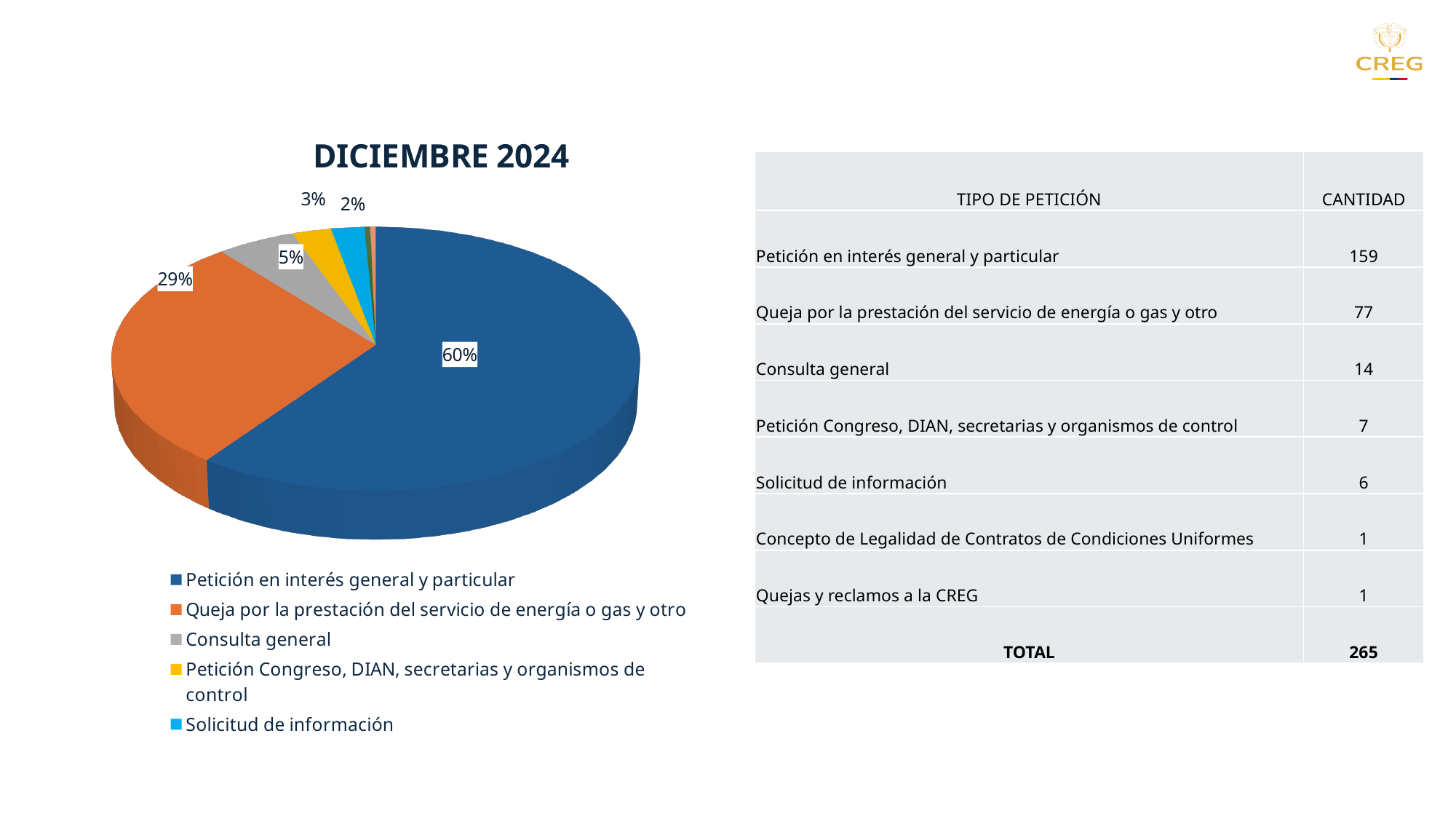
Which category has the largest slice of the pie? Petición en interés general y particular What share of the pie does 'Consulta general' represent? 5% What share of the pie does 'Queja por la prestación del servicio de energía o gas y otro' represent? 29% What is the difference in percentage points between the 'Petición en interés general y particular' slice and the 'Queja por la prestación del servicio de energía o gas y otro' slice? 31% Which slice is larger: 'Queja por la prestación del servicio de energía o gas y otro' or 'Consulta general'? Queja por la prestación del servicio de energía o gas y otro How many entries does the pie chart's legend list? 5 What share of the pie does 'Petición en interés general y particular' represent? 60% What colour is the slice for 'Consulta general'? Grey What is the title of the pie chart? DICIEMBRE 2024 What kind of chart is shown on the slide? Pie chart